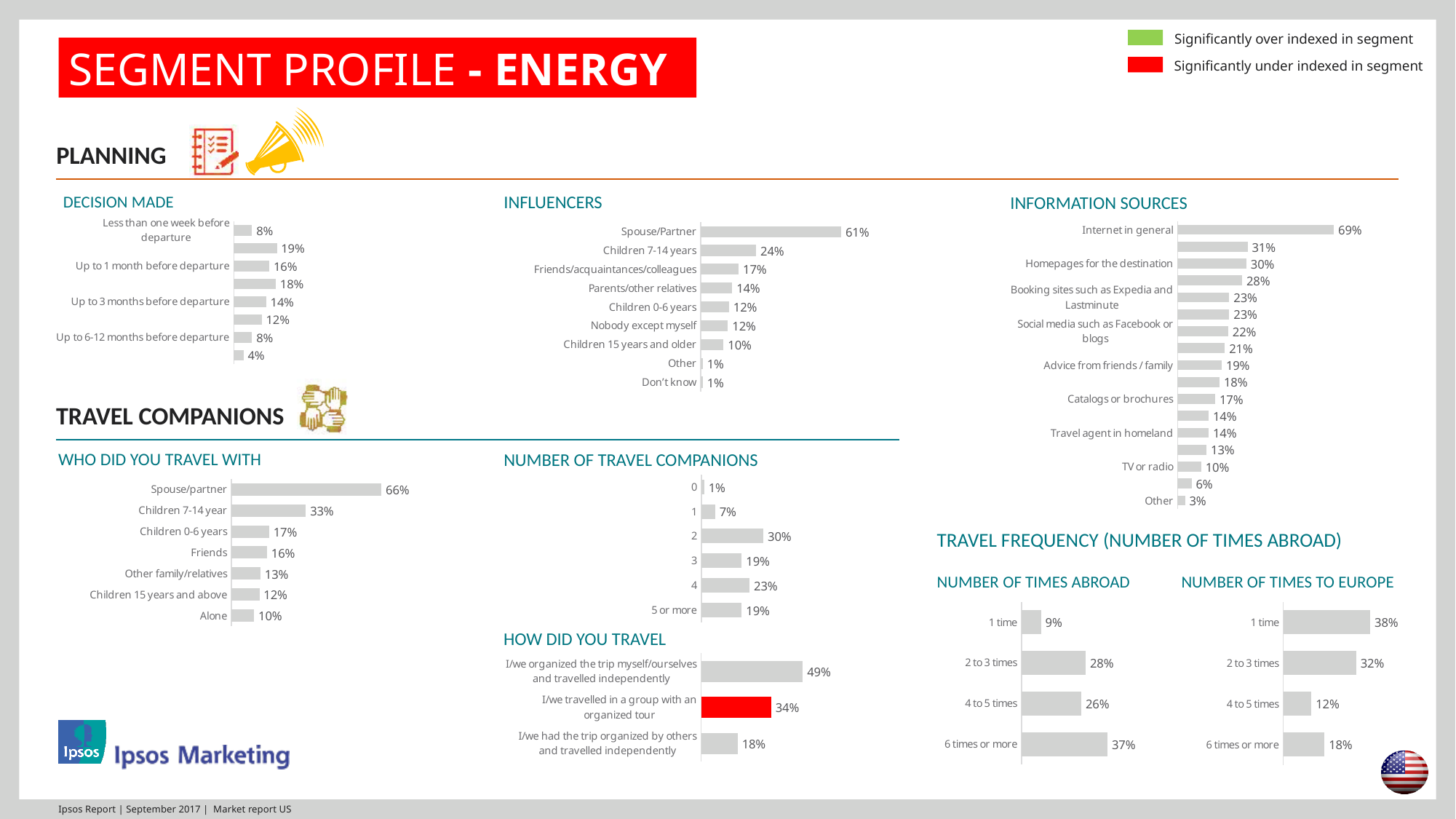
How many categories are shown in the NUMBER OF TRAVEL COMPANIONS chart? 6 In the NUMBER OF TIMES ABROAD chart, which is larger: 2 to 3 times or 6 times or more? 6 times or more In the NUMBER OF TIMES TO EUROPE chart, what is the value for 1 time? 38% In the HOW DID YOU TRAVEL chart, which bar is coloured red? I/we travelled in a group with an organized tour In the INFLUENCERS chart, what is the value for Spouse/Partner? 61% In the NUMBER OF TRAVEL COMPANIONS chart, what is the difference between the values for 2 and 3? 11% In the INFORMATION SOURCES chart, which category has the highest value? Internet in general What kind of chart is the INFLUENCERS chart? Bar chart In the INFORMATION SOURCES chart, what is the difference between the values for Internet in general and Other? 66% In the WHO DID YOU TRAVEL WITH chart, what is the value for Children 7-14 year? 33% In the WHO DID YOU TRAVEL WITH chart, which category has the lowest value? Alone In the HOW DID YOU TRAVEL chart, what is the value for 'I/we travelled in a group with an organized tour'? 34%